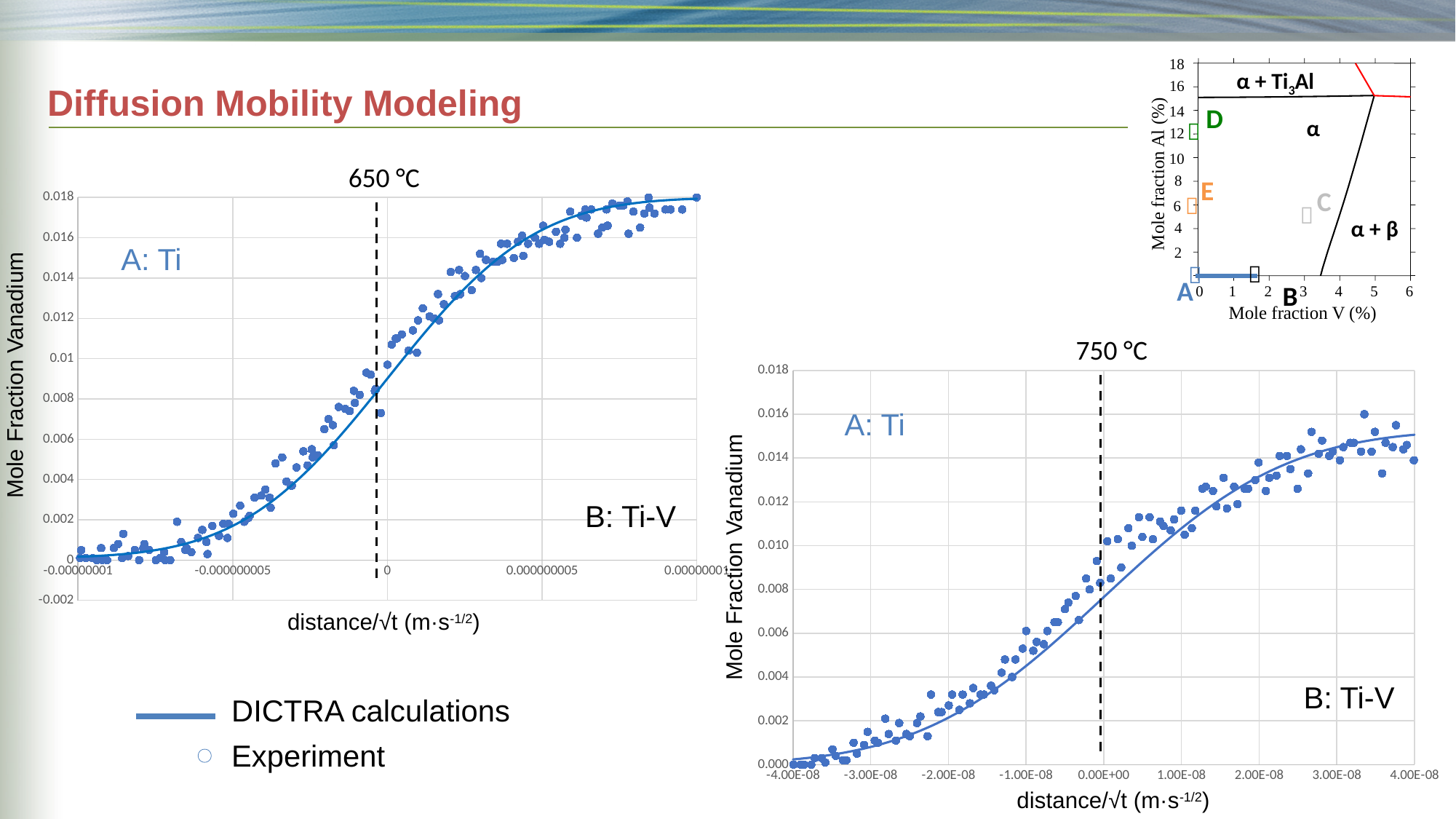
In the 650 °C chart, do the values rise or fall as distance/√t increases? rise In the 750 °C chart, is the value at distance/√t = 2.00E-08 greater or less than 0.010? greater In the 650 °C chart, is the value at distance/√t = 0.000000005 greater or less than 0.014? greater How many series does the legend at the bottom left of the slide list? 2 In the 750 °C chart, do the values rise or fall as distance/√t increases? rise What are the two series named in the legend? DICTRA calculations and Experiment What is the y-axis label of the 750 °C chart? Mole Fraction Vanadium In the 750 °C chart, is the value at distance/√t = -2.00E-08 greater or less than 0.004? less What kind of chart is the 650 °C chart? scatter chart